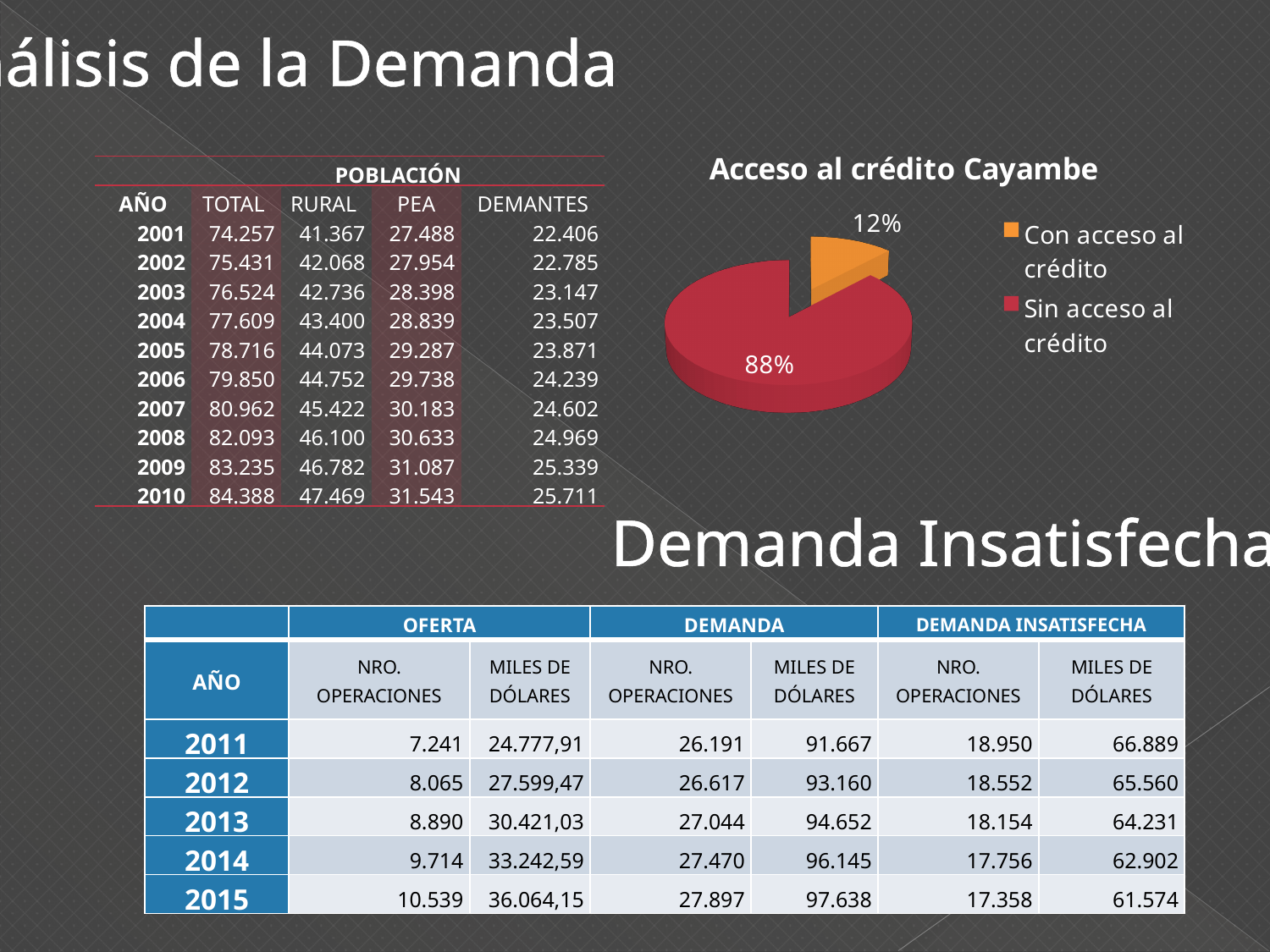
How many slices does the pie chart have? 2 In the pie chart, what is the difference in percentage points between "Sin acceso al crédito" and "Con acceso al crédito"? 76 In the pie chart, what share is labelled for "Con acceso al crédito"? 12% What kind of chart is shown under the title "Acceso al crédito Cayambe"? pie chart What is the title of the pie chart on the slide? Acceso al crédito Cayambe Which slice of the pie chart is the largest? Sin acceso al crédito In the pie chart, which is larger: "Con acceso al crédito" or "Sin acceso al crédito"? Sin acceso al crédito What colour is the "Con acceso al crédito" slice in the pie chart? orange How many entries does the legend of the pie chart list? 2 In the pie chart, what share is labelled for "Sin acceso al crédito"? 88% Which slice of the pie chart is the smallest? Con acceso al crédito